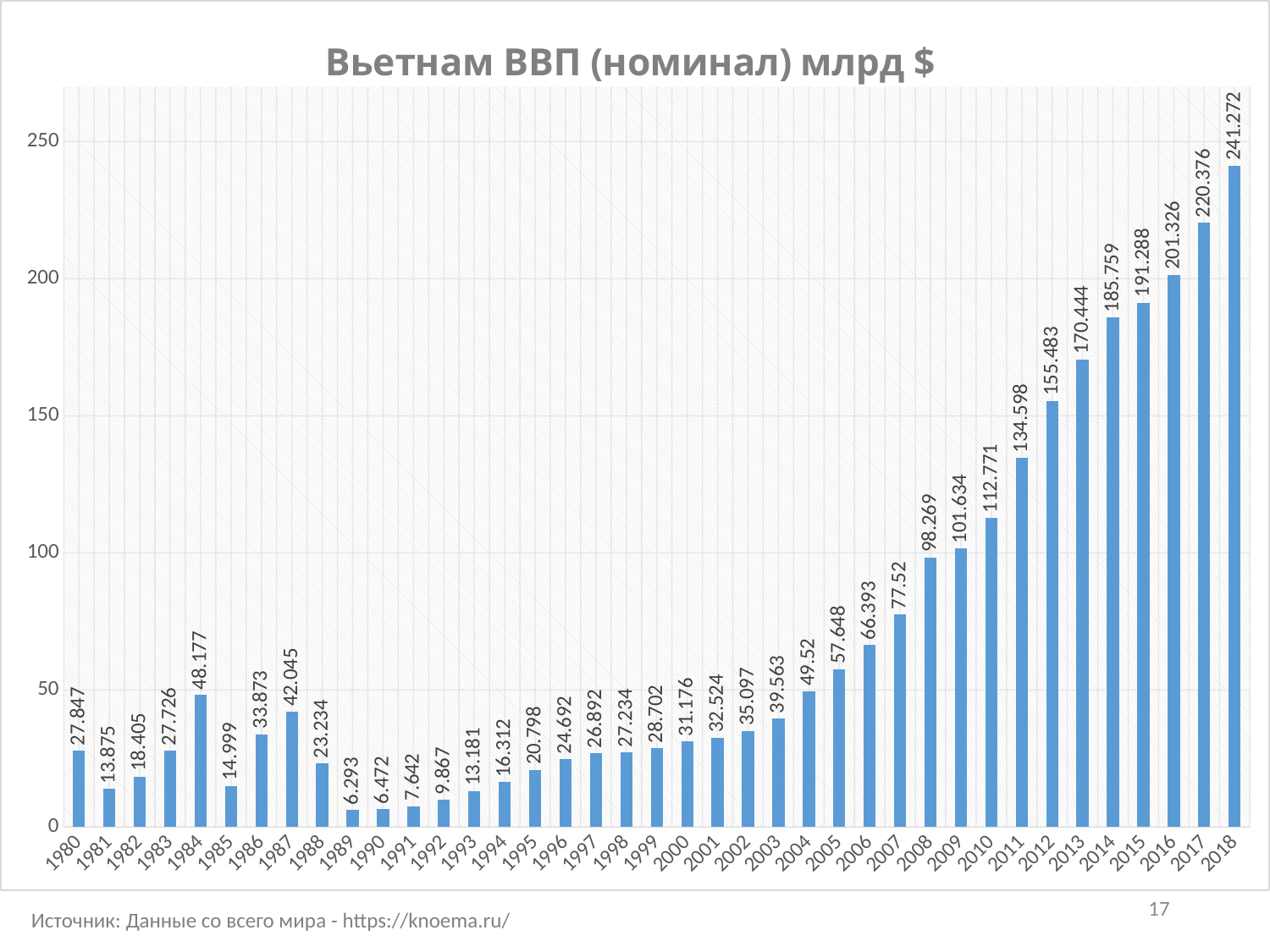
How many years are shown on the x axis? 39 Which year has the highest value? 2018 Is the value for 2010 greater or less than 100? greater What is the title of the chart? Вьетнам ВВП (номинал) млрд $ What is the value for 2018? 241.272 What is the difference between the values for 2018 and 2017? 20.896 What kind of chart is this? bar chart Which is larger, the value for 1987 or the value for 1986? 1987 Which year has the lowest value? 1989 What is the value for 2007? 77.52 What is the value for 1989? 6.293 What is the difference between the values for 1984 and 1983? 20.451